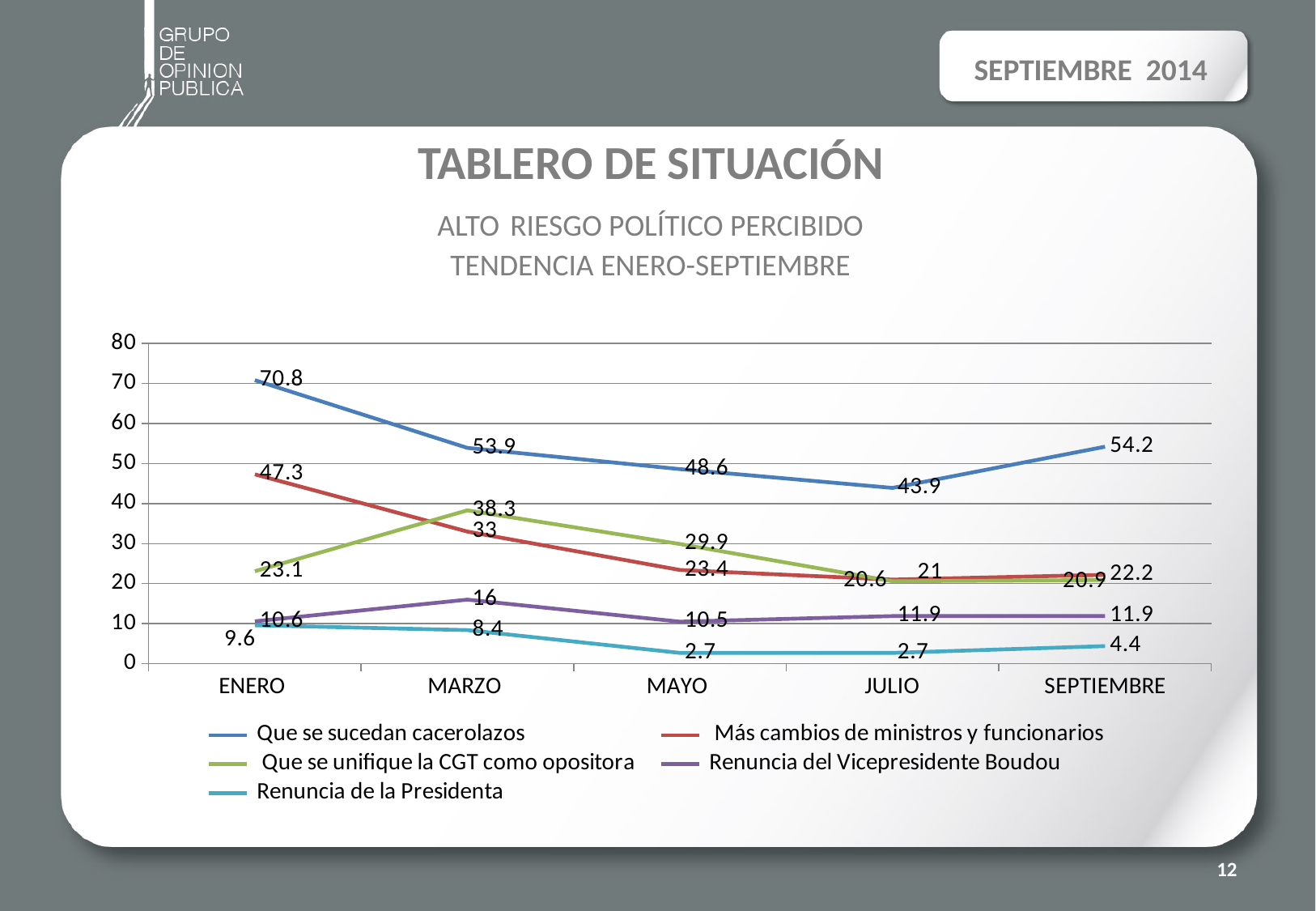
In which month is 'Que se sucedan cacerolazos' highest? ENERO What is the difference between the ENERO and SEPTIEMBRE values for 'Que se sucedan cacerolazos'? 16.6 What is the value for 'Que se unifique la CGT como opositora' in MARZO? 38.3 What kind of chart is shown on the slide? Line chart What is the value for 'Renuncia de la Presidenta' in MAYO? 2.7 What is the value for 'Más cambios de ministros y funcionarios' in MARZO? 33 How many months are shown on the x axis? 5 How many series does the legend list? 5 In MARZO, which is larger: 'Que se unifique la CGT como opositora' or 'Más cambios de ministros y funcionarios'? Que se unifique la CGT como opositora What is the value for 'Que se sucedan cacerolazos' in ENERO? 70.8 What is the value for 'Renuncia del Vicepresidente Boudou' in SEPTIEMBRE? 11.9 In which month is 'Que se sucedan cacerolazos' lowest? JULIO